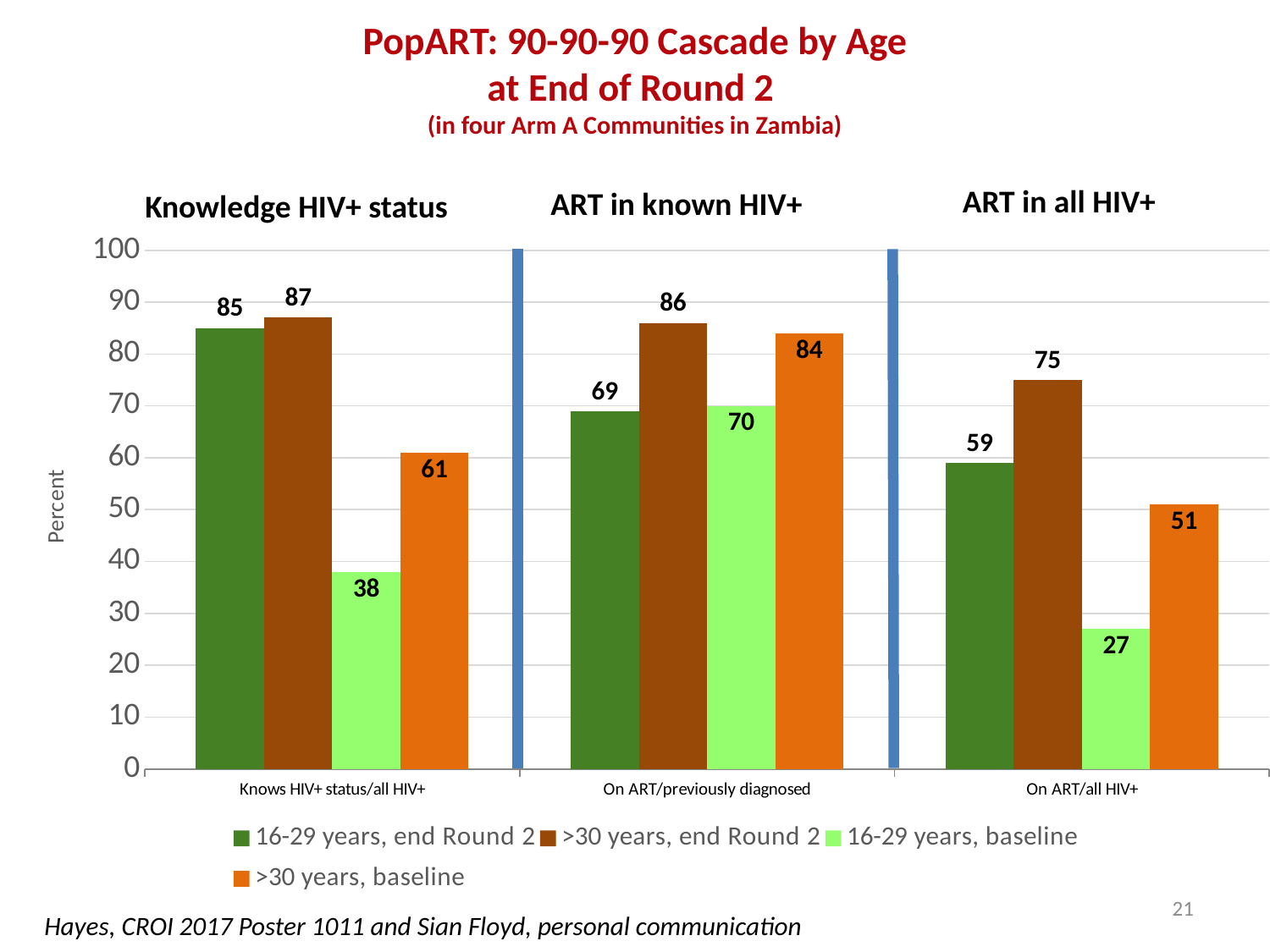
What is the value for >30 years, baseline in the On ART/all HIV+ category? 51 What kind of chart is shown on the slide? bar chart What is the value for 16-29 years, baseline in the On ART/previously diagnosed category? 70 Which series has the lowest value in the On ART/all HIV+ category? 16-29 years, baseline What is the label of the y axis? Percent How many series does the legend list? 4 What is the value for 16-29 years, end Round 2 in the Knows HIV+ status/all HIV+ category? 85 Which is larger in the On ART/previously diagnosed category: >30 years, end Round 2 or >30 years, baseline? >30 years, end Round 2 What is the difference between the 16-29 years, end Round 2 and 16-29 years, baseline values in the Knows HIV+ status/all HIV+ category? 47 Which series has the highest value in the On ART/previously diagnosed category? >30 years, end Round 2 How many categories are shown on the x axis? 3 What is the difference between the >30 years, end Round 2 and 16-29 years, end Round 2 values in the On ART/all HIV+ category? 16